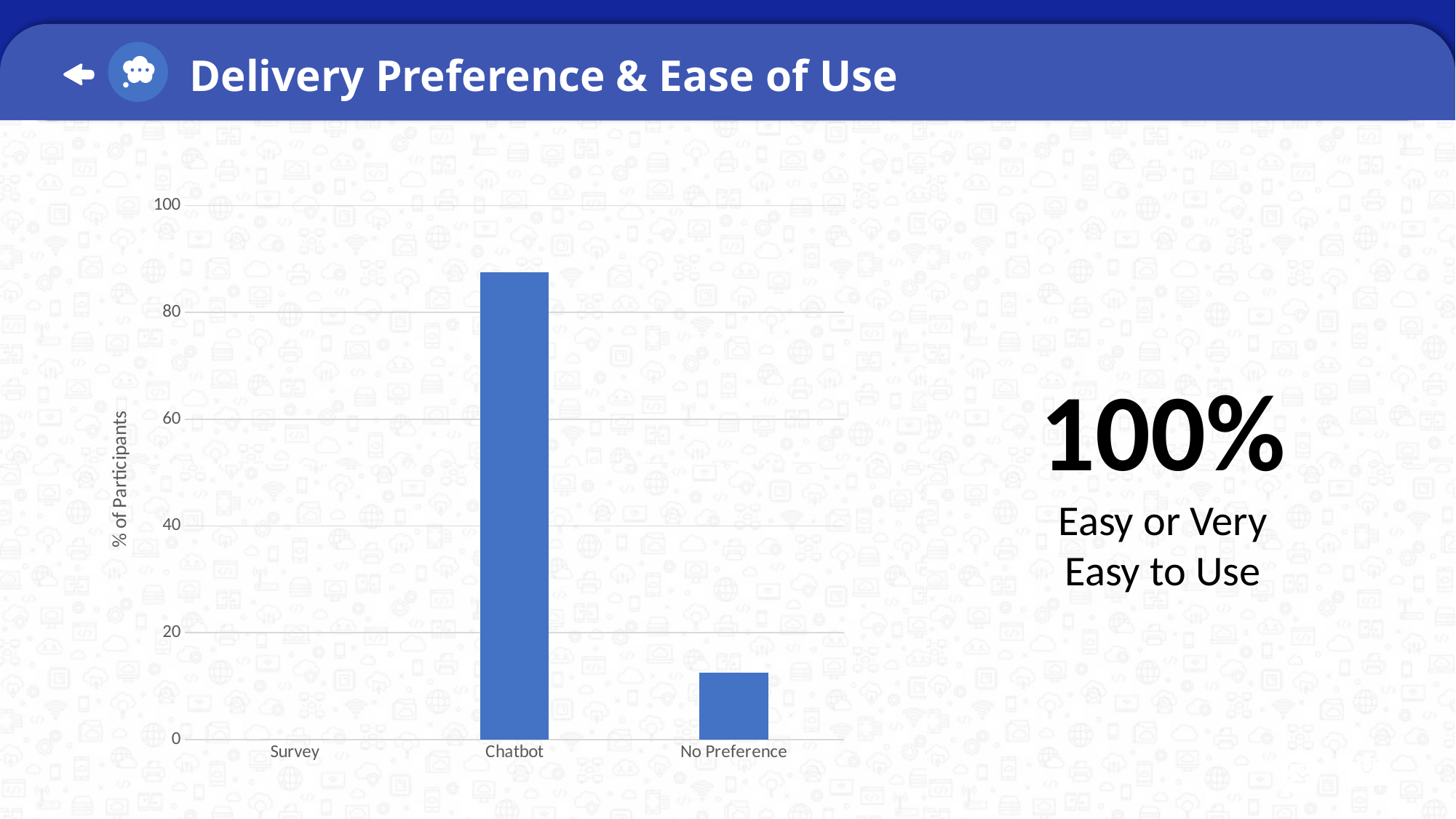
Which category has the lowest value in the chart? Survey Is the value for Chatbot greater or less than 80? greater Which category has the highest value in the chart? Chatbot How many categories are shown on the x axis of the chart? 3 Is the value for Chatbot greater or less than 100? less Is the value for No Preference greater or less than 20? less What is the highest tick value shown on the y axis of the chart? 100 What is the label of the y axis of the chart? % of Participants Which has a larger value, Survey or No Preference? No Preference What kind of chart is shown on the slide? bar chart Which has a larger value, Chatbot or No Preference? Chatbot